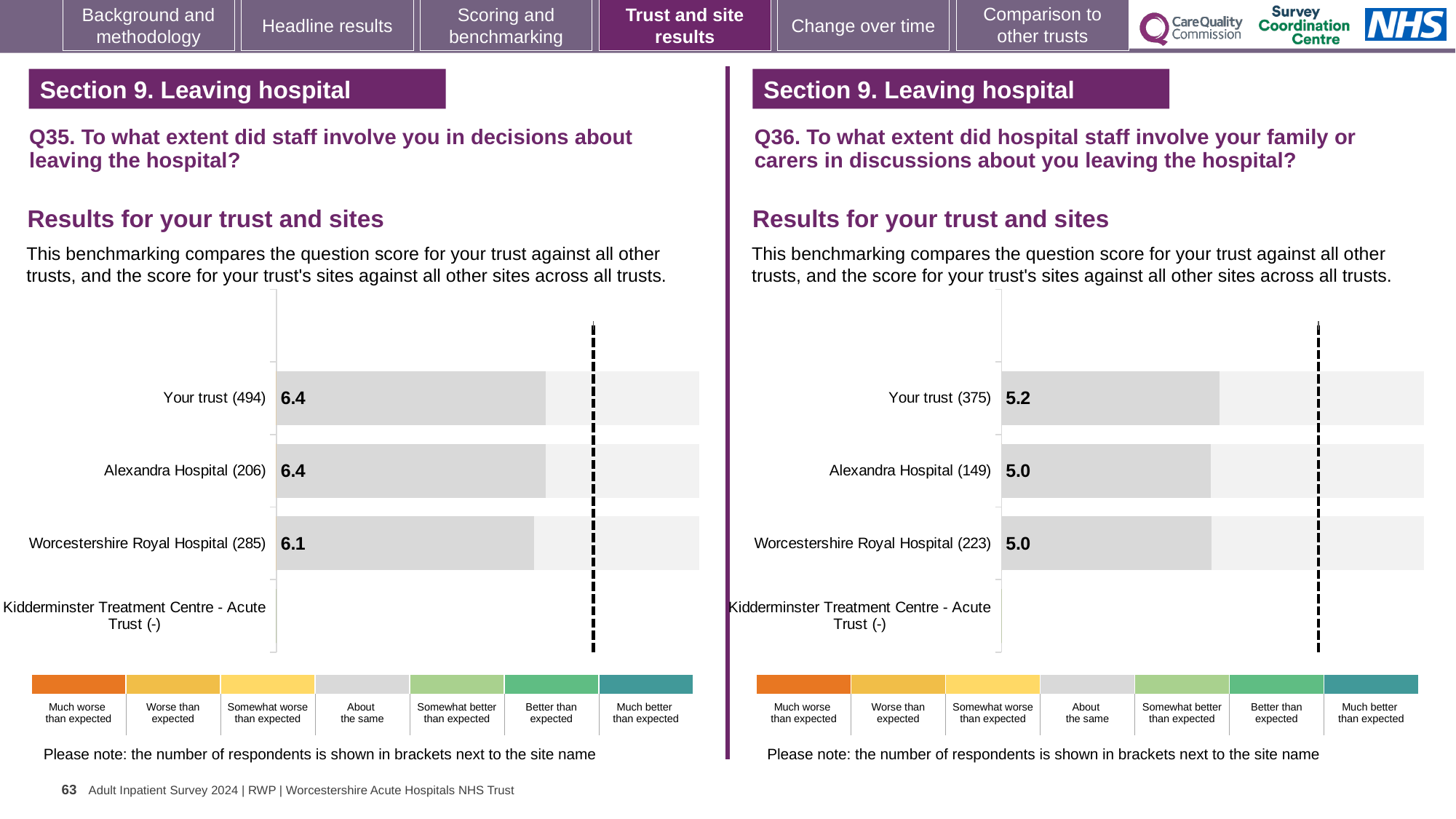
In the Q35 chart on the left, what is the score for Your trust? 6.4 In the Q35 chart on the left, which site has the lowest score among those with a plotted bar? Worcestershire Royal Hospital How many rows (sites including Your trust) are listed in the Q36 chart on the right? 4 In the Q36 chart on the right, which row has the highest score? Your trust In the Q36 chart on the right, what is the score for Alexandra Hospital? 5.0 In the Q36 chart on the right, what is the difference between the score for Your trust and the score for Worcestershire Royal Hospital? 0.2 In the Q35 chart on the left, how many respondents are shown in brackets for Alexandra Hospital? 206 In the Q35 chart on the left, what is the difference between the score for Alexandra Hospital and the score for Worcestershire Royal Hospital? 0.3 In the Q35 chart on the left, what is the score for Worcestershire Royal Hospital? 6.1 In the Q36 chart on the right, what is the score for Your trust? 5.2 What kind of chart is used in the Q35 chart on the left? bar chart In the Q35 chart on the left, is the score for Your trust larger or smaller than the score for Worcestershire Royal Hospital? larger